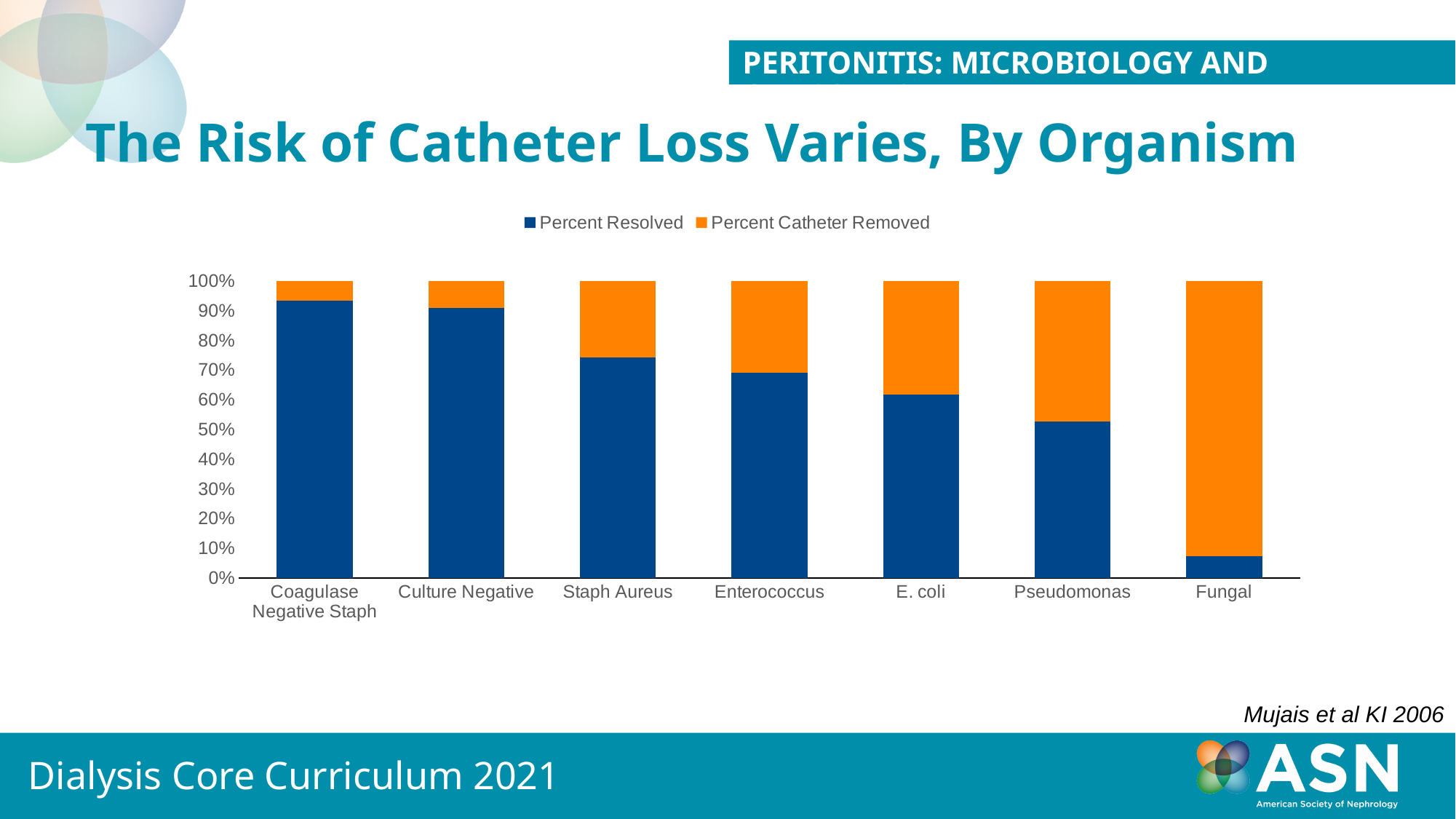
What is the total of the stacked bar for E. coli? 100% Is the Percent Resolved for Culture Negative greater or less than 80%? greater Which organism has the highest Percent Catheter Removed? Fungal Is the Percent Resolved for Staph Aureus greater or less than 70%? greater Which organism has the lowest Percent Resolved? Fungal How many series does the legend list? 2 Is the Percent Resolved for Fungal greater or less than 10%? less How many organism categories are shown on the x axis? 7 What kind of chart is shown on the slide? stacked bar chart Does the Percent Resolved rise or fall moving from left to right across the organisms? fall Which has a larger Percent Resolved, Enterococcus or Pseudomonas? Enterococcus